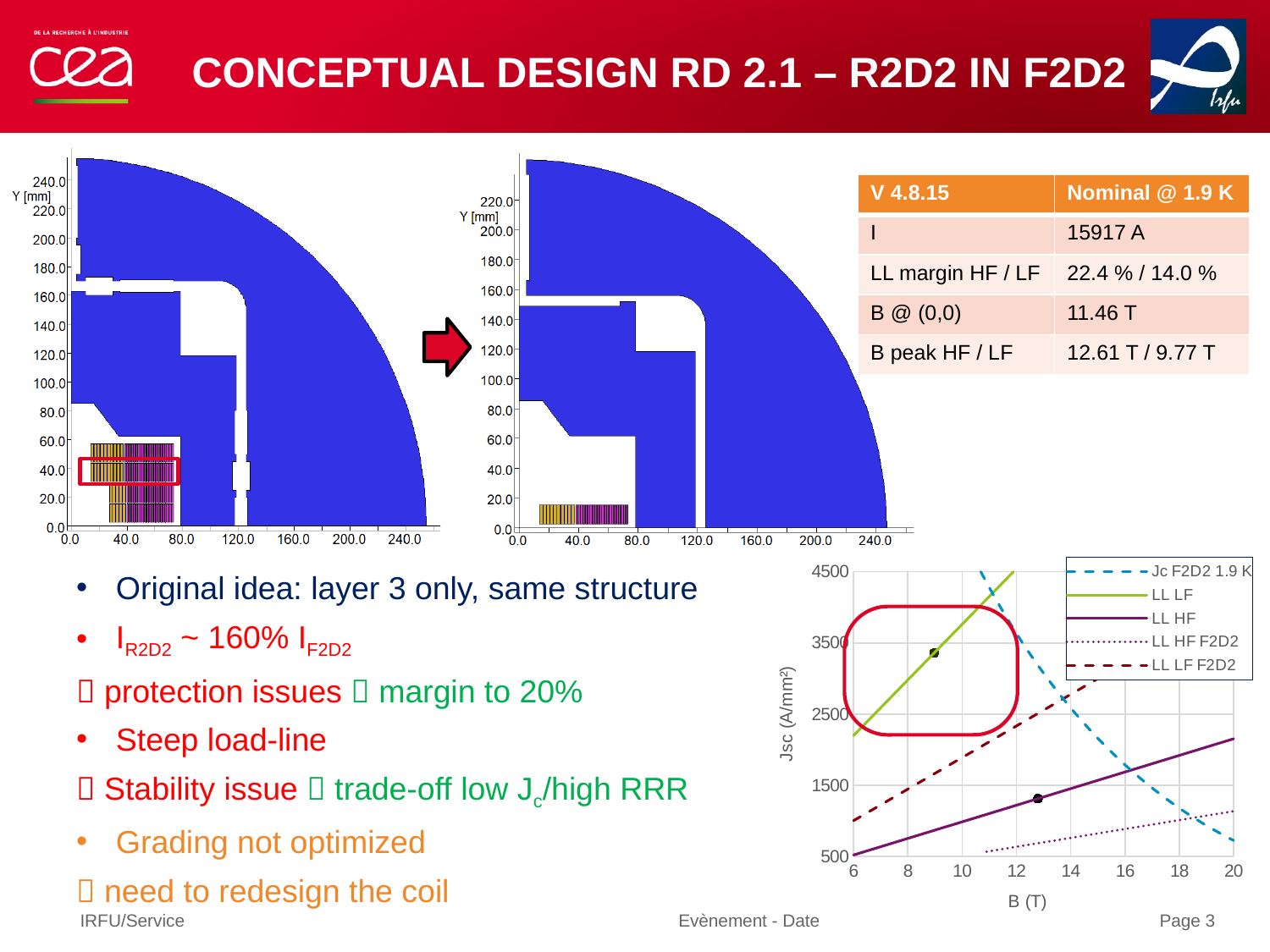
How many series does the legend of the Jsc vs B chart list? 5 In the Jsc vs B chart, at B = 10 T, which is higher: LL LF or LL LF F2D2? LL LF In the Jsc vs B chart, does the LL LF line rise or fall as B increases? rise In the Jsc vs B chart, is the value of Jc F2D2 1.9 K at B = 20 T greater or less than 1500? less In the Jsc vs B chart, is the value of LL HF at B = 6 T greater or less than 1500? less What is the lowest value shown on the x axis of the Jsc vs B chart? 6 What is the label of the y axis of the line chart at the bottom right? Jsc (A/mm²) What is the label of the x axis of the Jsc vs B chart? B (T) In the Jsc vs B chart, does the Jc F2D2 1.9 K curve rise or fall as B increases? fall In the Jsc vs B chart, at B = 14 T, which is higher: LL HF or LL HF F2D2? LL HF In the Jsc vs B chart, is the value of LL HF F2D2 at B = 20 T greater or less than 1500? less What kind of chart is shown at the bottom right of the slide? line chart